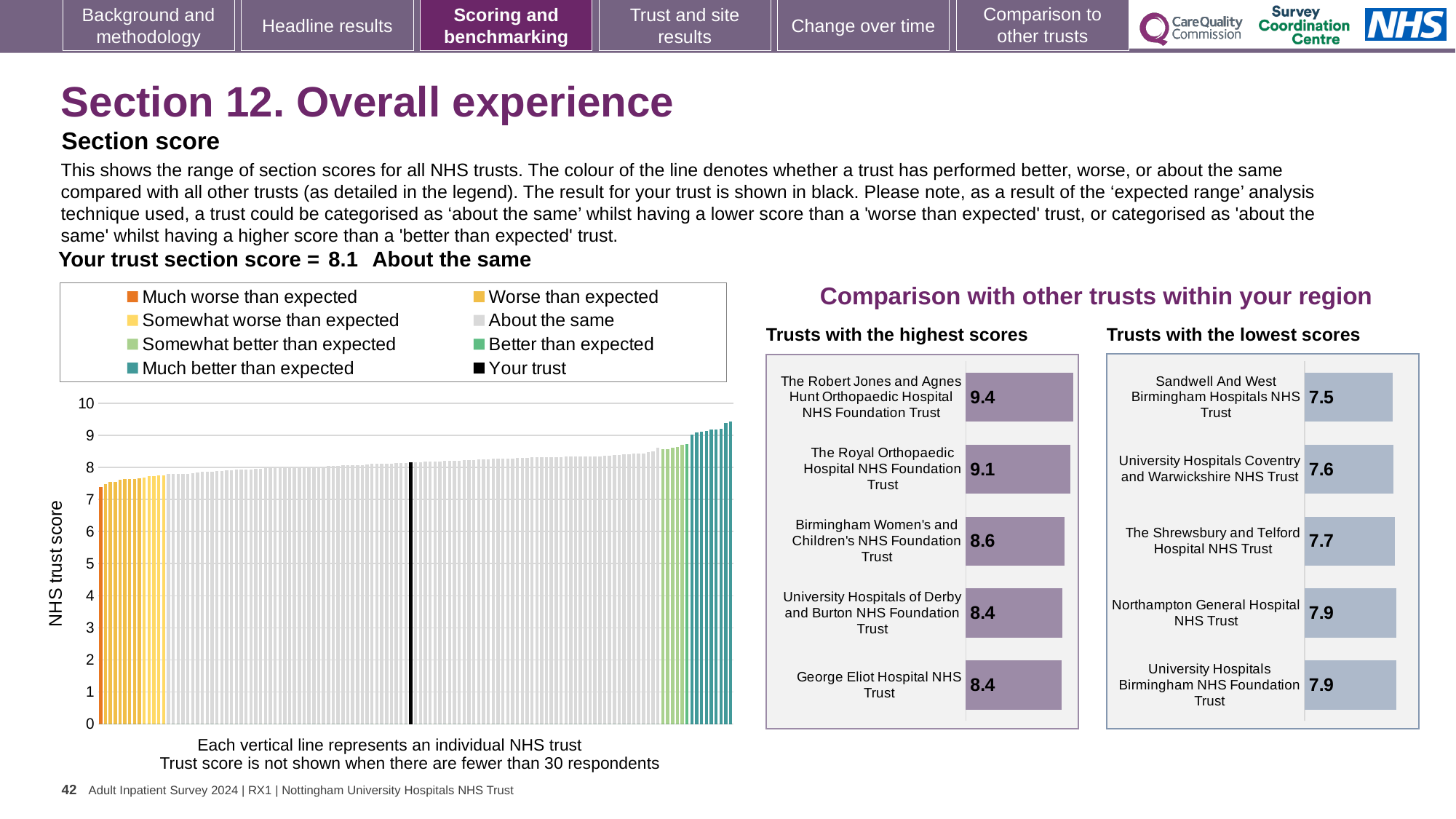
In the 'Trusts with the highest scores' chart, what is the score for The Robert Jones and Agnes Hunt Orthopaedic Hospital NHS Foundation Trust? 9.4 In the 'Trusts with the lowest scores' chart, what is the score for The Shrewsbury and Telford Hospital NHS Trust? 7.7 What type of chart is the large chart on the left showing NHS trust scores? Bar chart In the 'Trusts with the highest scores' chart, which has the higher score: The Royal Orthopaedic Hospital NHS Foundation Trust or University Hospitals of Derby and Burton NHS Foundation Trust? The Royal Orthopaedic Hospital NHS Foundation Trust How many trusts are shown in the 'Trusts with the lowest scores' chart? 5 In the 'Trusts with the highest scores' chart, what is the difference between the scores of The Robert Jones and Agnes Hunt Orthopaedic Hospital NHS Foundation Trust and Birmingham Women's and Children's NHS Foundation Trust? 0.8 In the 'Trusts with the lowest scores' chart, what is the difference between the scores of Northampton General Hospital NHS Trust and Sandwell And West Birmingham Hospitals NHS Trust? 0.4 In the 'Trusts with the highest scores' chart, which trust has the highest score? The Robert Jones and Agnes Hunt Orthopaedic Hospital NHS Foundation Trust In the large chart on the left, is the value for the highest-scoring trust greater or less than 9? greater In the 'Trusts with the highest scores' chart, what is the score for Birmingham Women's and Children's NHS Foundation Trust? 8.6 How many entries does the legend of the large chart on the left list? 8 In the 'Trusts with the lowest scores' chart, which trust has the lowest score? Sandwell And West Birmingham Hospitals NHS Trust